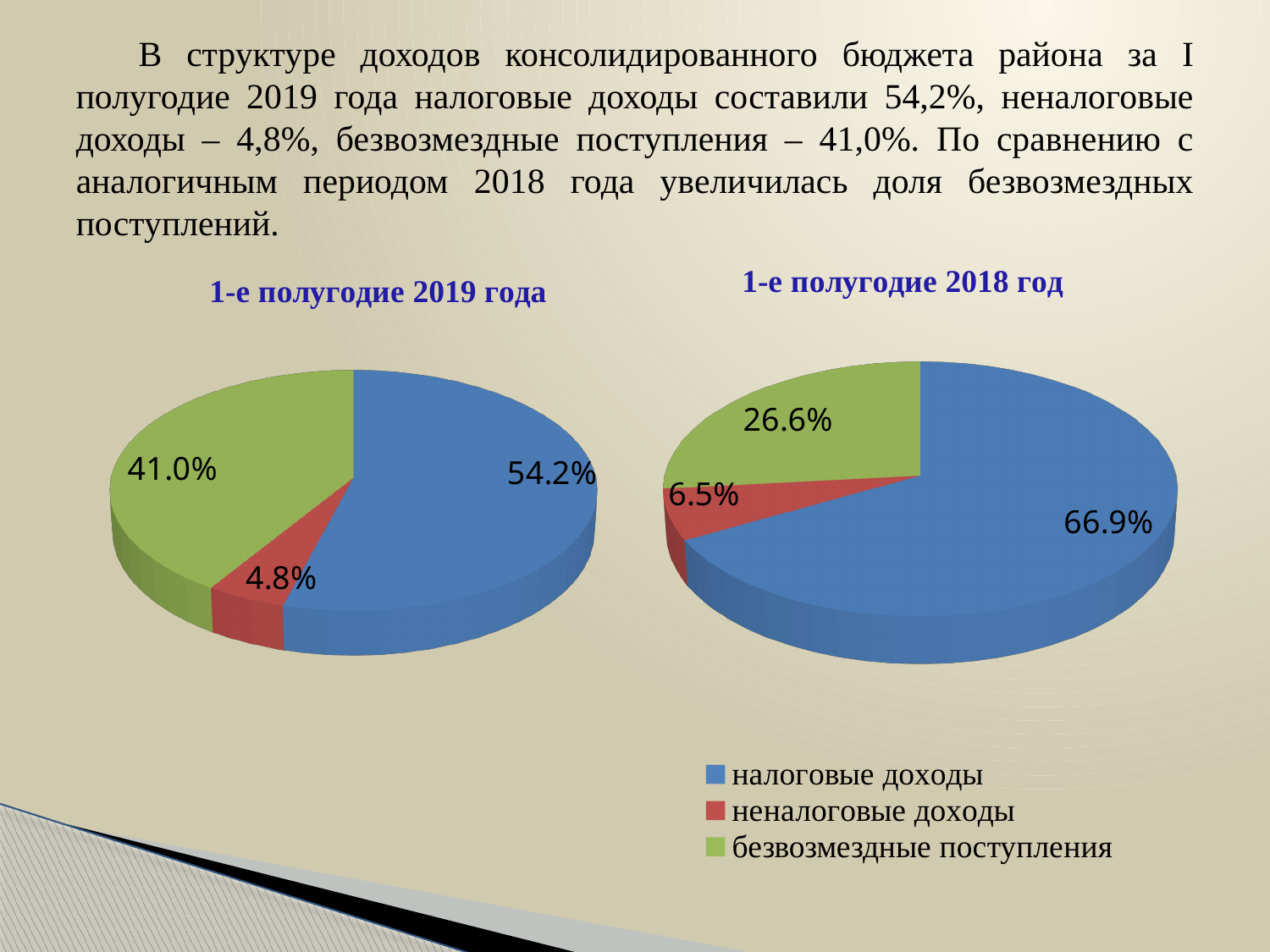
In the chart titled "1-е полугодие 2019 года", which category has the largest slice? налоговые доходы In the chart titled "1-е полугодие 2019 года", what share do неналоговые доходы have? 4.8% What type of chart is the chart titled "1-е полугодие 2019 года"? pie chart In the chart titled "1-е полугодие 2018 год", what share do неналоговые доходы have? 6.5% How many entries does the legend list? 3 Which is larger: the share of безвозмездные поступления in the 2019 chart or in the 2018 chart? 2019 chart In the chart titled "1-е полугодие 2019 года", what is the difference between the shares of налоговые доходы and безвозмездные поступления? 13.2% In the chart titled "1-е полугодие 2018 год", what share do безвозмездные поступления have? 26.6% In the chart titled "1-е полугодие 2018 год", which category has the smallest slice? неналоговые доходы How many categories does the chart titled "1-е полугодие 2018 год" show? 3 What colour represents безвозмездные поступления in the charts? green In the chart titled "1-е полугодие 2019 года", what share do налоговые доходы have? 54.2%